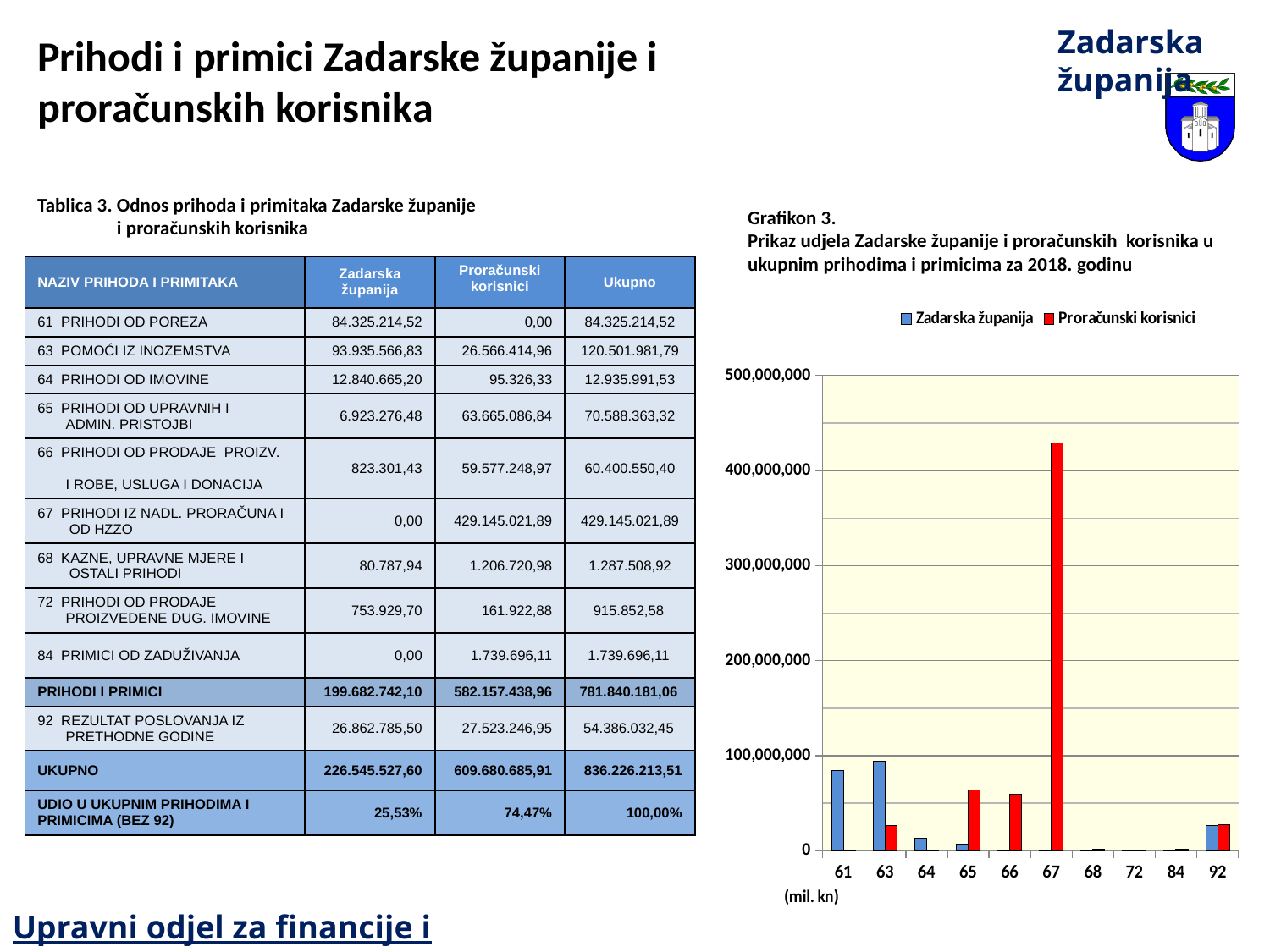
In Grafikon 3, which category has the highest value for Proračunski korisnici? 67 How many categories are shown on the x axis of Grafikon 3? 10 In Grafikon 3, which colour represents the Proračunski korisnici series? red In Grafikon 3, is the Zadarska županija value for category 61 greater or less than 100,000,000? less In Grafikon 3, is the Proračunski korisnici value for category 65 greater or less than 100,000,000? less How many series does the legend of Grafikon 3 list? 2 In Grafikon 3, which category has the highest value for Zadarska županija? 63 In Grafikon 3, is the Proračunski korisnici value for category 67 greater or less than 400,000,000? greater In Grafikon 3, for category 61, which series has the larger value: Zadarska županija or Proračunski korisnici? Zadarska županija What kind of chart is Grafikon 3? bar chart In Grafikon 3, for category 67, which series has the larger value: Zadarska županija or Proračunski korisnici? Proračunski korisnici What unit is indicated below the x axis of Grafikon 3? (mil. kn)